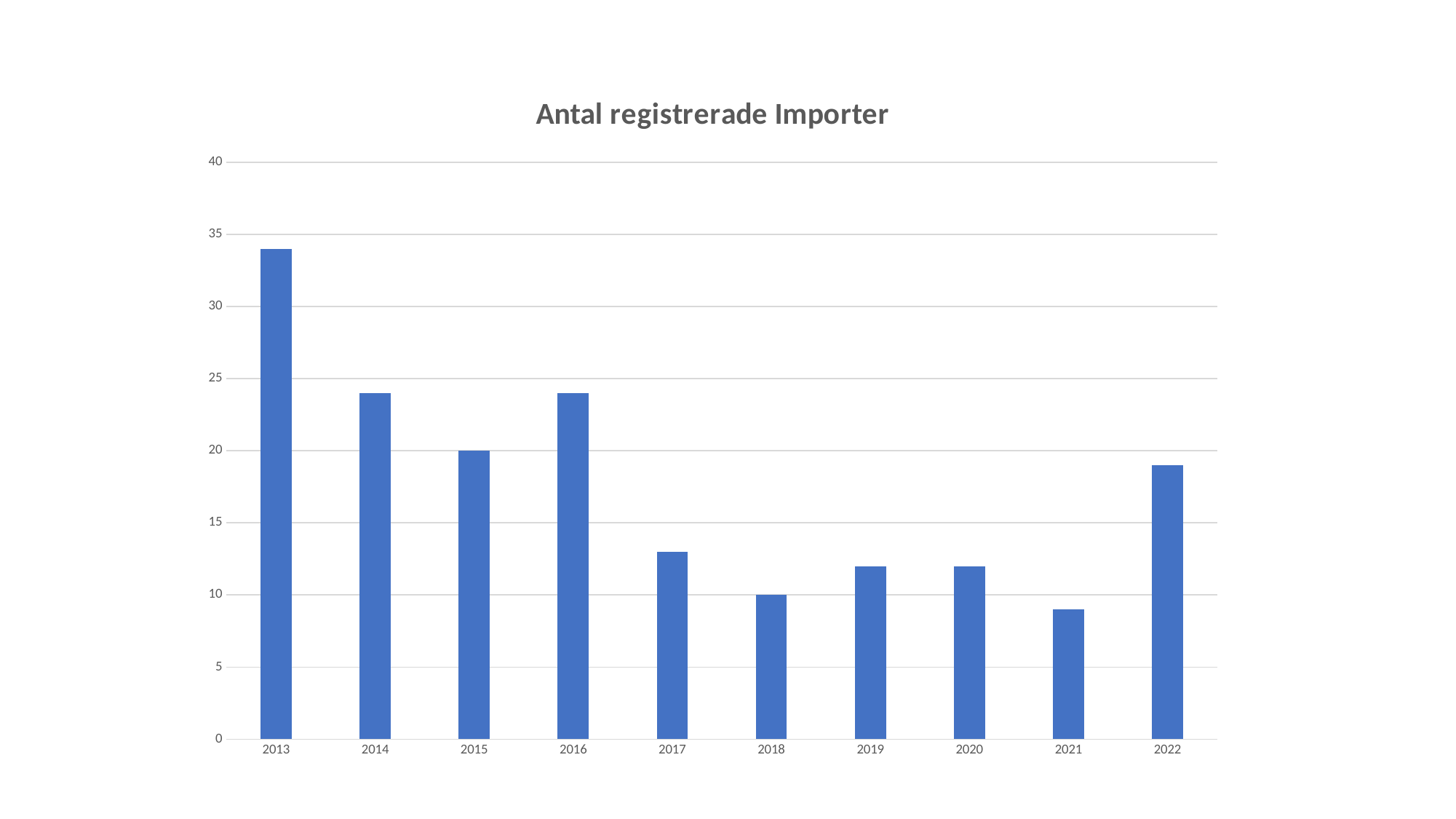
Which year has a larger value, 2013 or 2014? 2013 What is the title of the chart? Antal registrerade Importer Which year has the highest number of registered imports? 2013 What kind of chart is shown on the slide? bar chart Which year has the lowest number of registered imports? 2021 Is the value for 2017 greater or less than 15? less What is the value for 2018? 10 What is the value for 2015? 20 Do the values generally rise or fall from 2013 to 2018? fall Is the value for 2013 greater or less than 30? greater How many years are shown on the x axis of the chart? 10 Is the value for 2022 greater or less than 15? greater